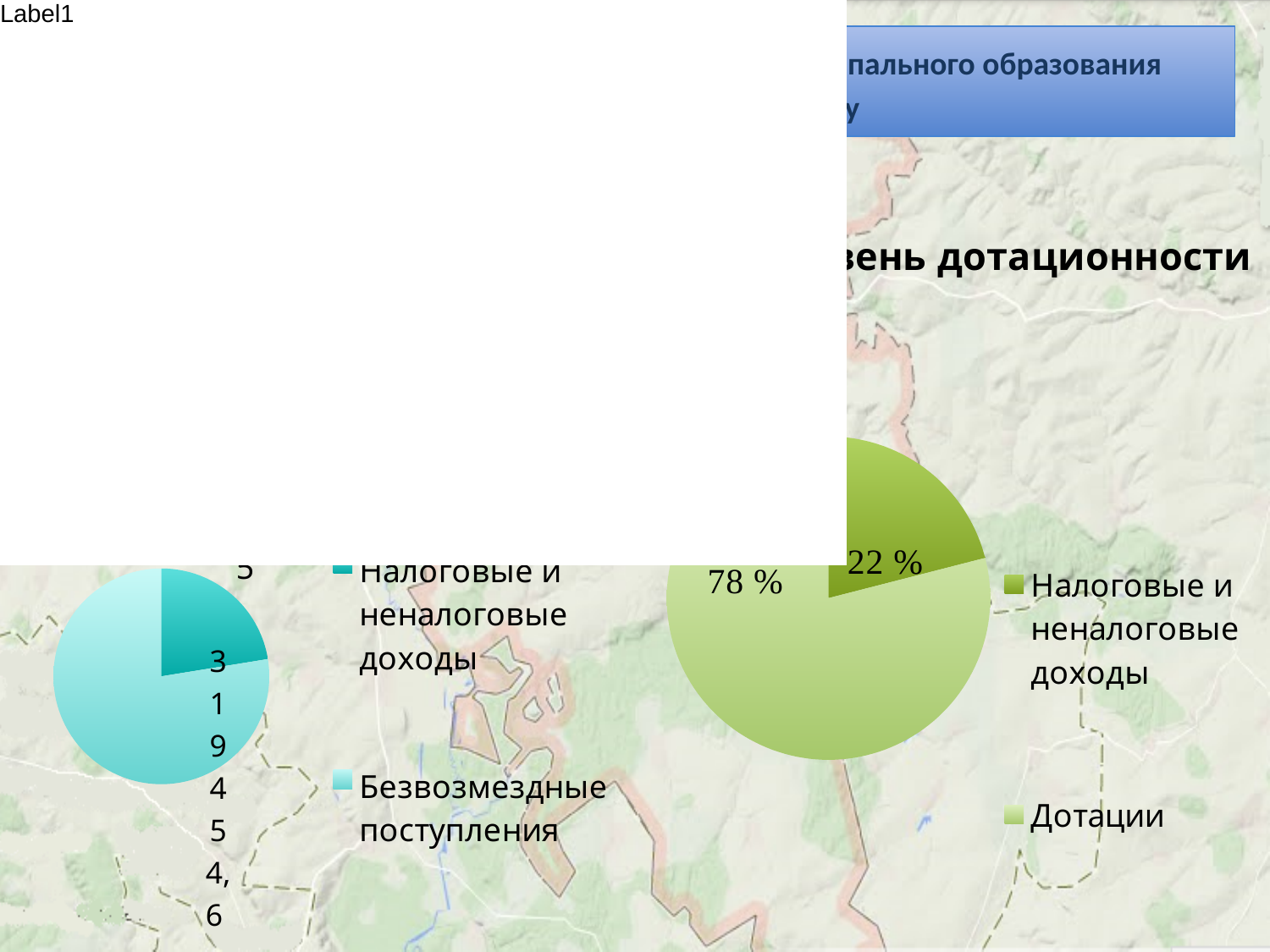
What kind of chart is the left chart on the slide? Pie chart In the right pie chart, which slice is larger: Дотации or Налоговые и неналоговые доходы? Дотации In the left pie chart, which slice is larger: Налоговые и неналоговые доходы or Безвозмездные поступления? Безвозмездные поступления What is the second legend entry of the right chart? Дотации What kind of chart is the right chart on the slide? Pie chart How many entries does the legend of the left chart list? 2 In the right pie chart, what share is shown for Дотации? 78 % In the right pie chart, what share is shown for Налоговые и неналоговые доходы? 22 % How many entries does the legend of the right chart list? 2 In the right pie chart, which category has the largest slice? Дотации In the right pie chart, what is the difference between the Дотации share and the Налоговые и неналоговые доходы share? 56 % In the left pie chart, which category has the smallest slice? Налоговые и неналоговые доходы